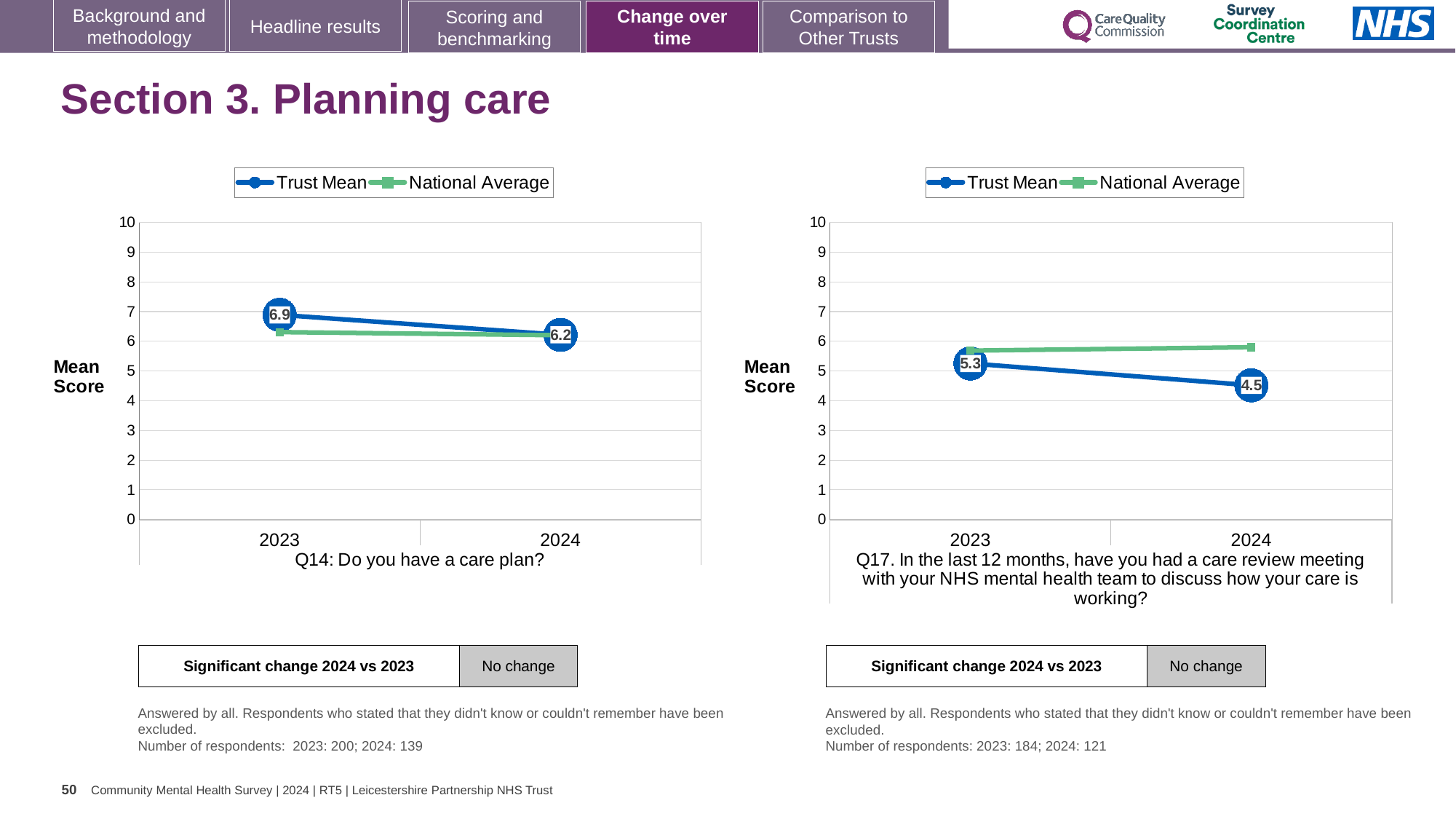
In the right chart (Q17), does the Trust Mean rise or fall from 2023 to 2024? fall In the right chart (Q17, care review meeting), what is the Trust Mean score for 2024? 4.5 How many series does the legend of the right chart (Q17) list? 2 In the left chart (Q14: Do you have a care plan?), what is the Trust Mean score for 2024? 6.2 In the right chart (Q17, care review meeting), what is the Trust Mean score for 2023? 5.3 In the right chart (Q17), what is the difference between the Trust Mean in 2023 and in 2024? 0.8 How many years are shown on the x axis of the left chart (Q14)? 2 In the left chart (Q14: Do you have a care plan?), what is the Trust Mean score for 2023? 6.9 In the right chart (Q17), is the National Average for 2024 greater or less than 5? greater In the right chart (Q17), which is higher in 2024: the Trust Mean or the National Average? National Average In the left chart (Q14), by how much did the Trust Mean fall from 2023 to 2024? 0.7 What kind of chart is the left chart (Q14)? line chart